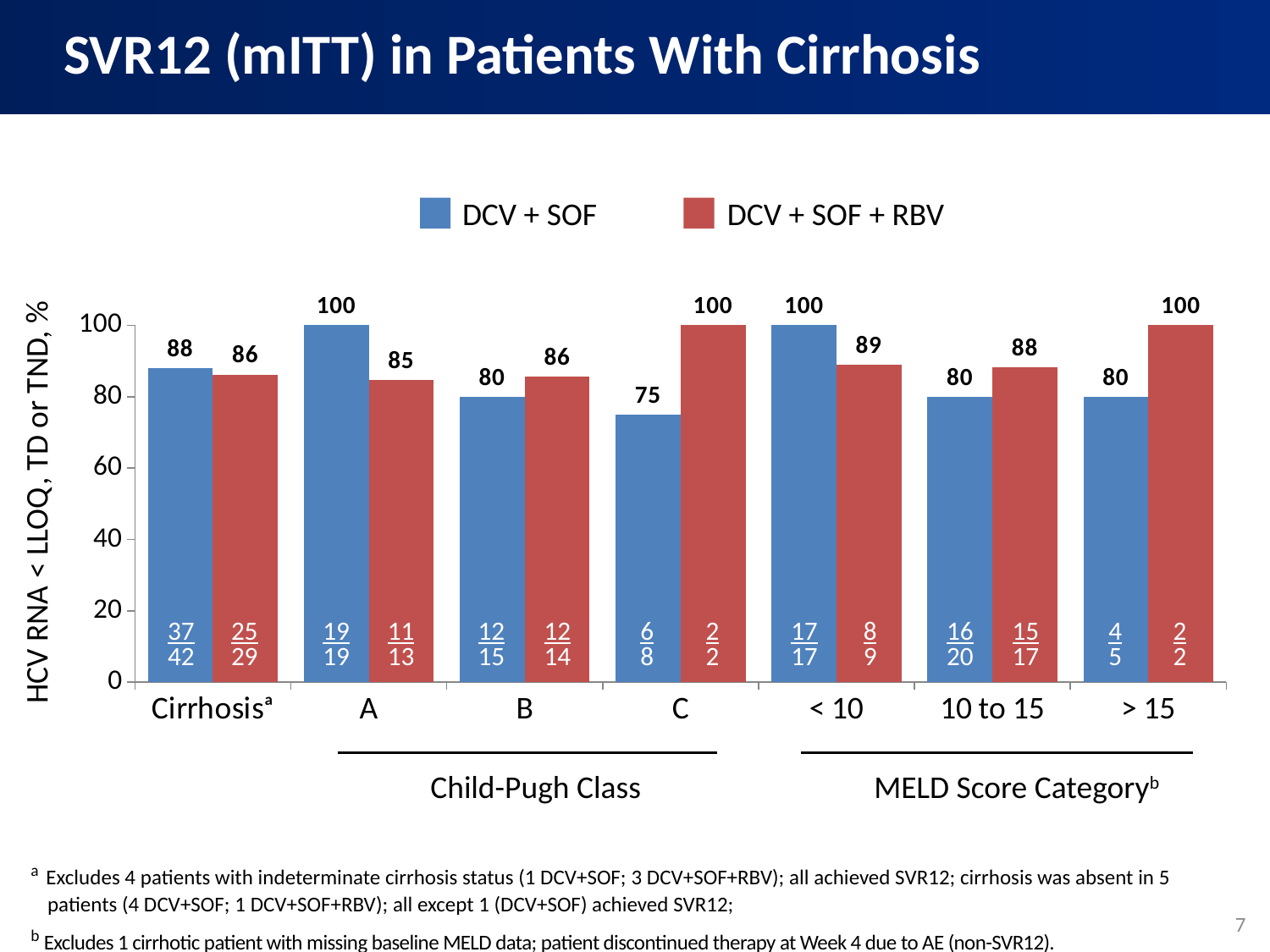
How many categories are shown on the x axis of the chart? 7 How many series does the legend list? 2 What is the y-axis label of the chart? HCV RNA < LLOQ, TD or TND, % What is the SVR12 value for DCV + SOF in the Cirrhosis category? 88 What is the difference between the DCV + SOF + RBV and DCV + SOF values in Child-Pugh Class C? 25 In Child-Pugh Class A, which series has the higher SVR12 value, DCV + SOF or DCV + SOF + RBV? DCV + SOF In the MELD Score Category > 15, which series has the higher SVR12 value? DCV + SOF + RBV Which category has the lowest SVR12 value for DCV + SOF? C What is the SVR12 value for DCV + SOF + RBV in Child-Pugh Class C? 100 What is the SVR12 value for DCV + SOF + RBV in the MELD Score Category 10 to 15? 88 What is the SVR12 value for DCV + SOF in Child-Pugh Class C? 75 What kind of chart is shown on the slide? Bar chart